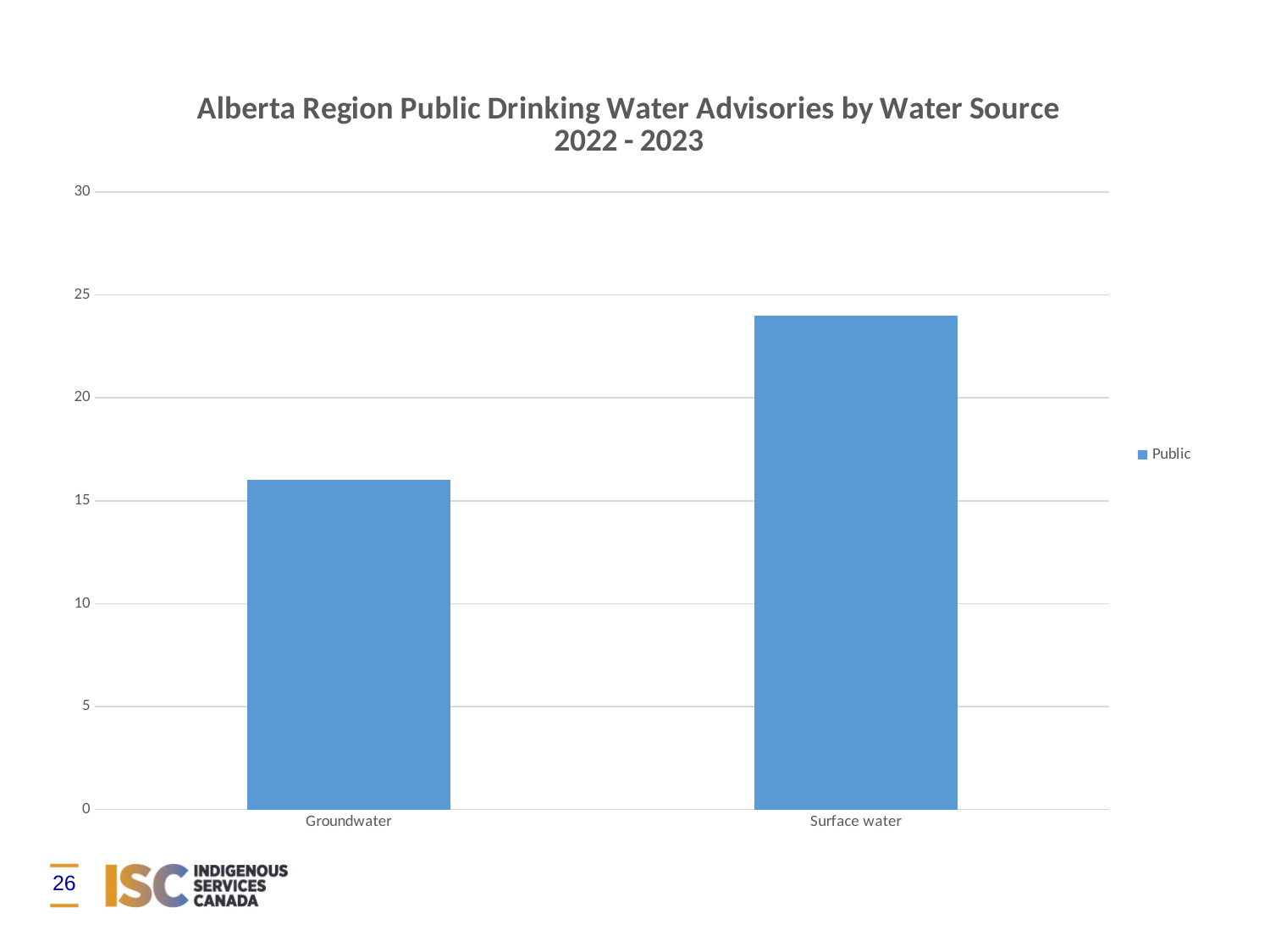
What series name is shown in the legend? Public Is the value for Surface water greater or less than 20? greater Which is larger, the value for Groundwater or the value for Surface water? Surface water Which water source has the lowest number of public drinking water advisories? Groundwater Is the value for Groundwater greater or less than 15? greater What is the title of the chart? Alberta Region Public Drinking Water Advisories by Water Source 2022 - 2023 What type of chart is shown on the slide? bar chart How many water source categories are shown on the x axis? 2 Is the value for Groundwater greater or less than 20? less How many series does the legend list? 1 Which water source has the highest number of public drinking water advisories? Surface water